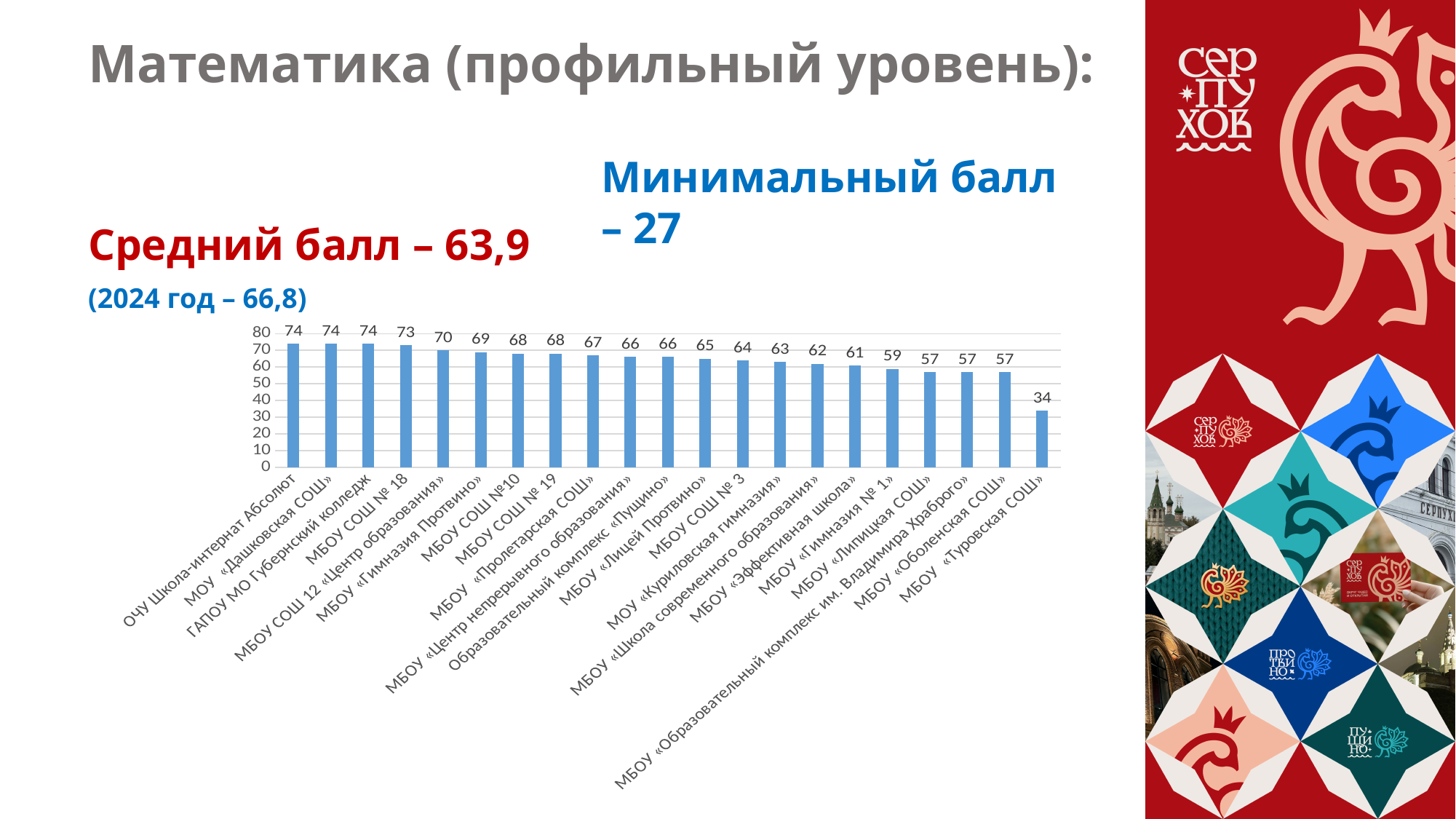
What is the difference between the values for ОЧУ Школа-интернат Абсолют and МБОУ «Туровская СОШ»? 40 What is the value for МБОУ «Лицей Протвино»? 65 What is the highest value shown on the vertical axis of the chart? 80 What type of chart is shown on the slide? bar chart How many categories are shown on the x axis of the chart? 21 What is the value for МБОУ «Гимназия № 1»? 59 What is the difference between the values for МБОУ СОШ 12 «Центр образования» and МБОУ «Эффективная школа»? 9 Which is larger: the value for МБОУ «Гимназия Протвино» or the value for МОУ «Куриловская гимназия»? МБОУ «Гимназия Протвино» Which category has the lowest value? МБОУ «Туровская СОШ» What is the value for МБОУ СОШ № 18? 73 What is the value for МБОУ «Туровская СОШ»? 34 Do the values generally rise or fall from left to right along the x axis? fall